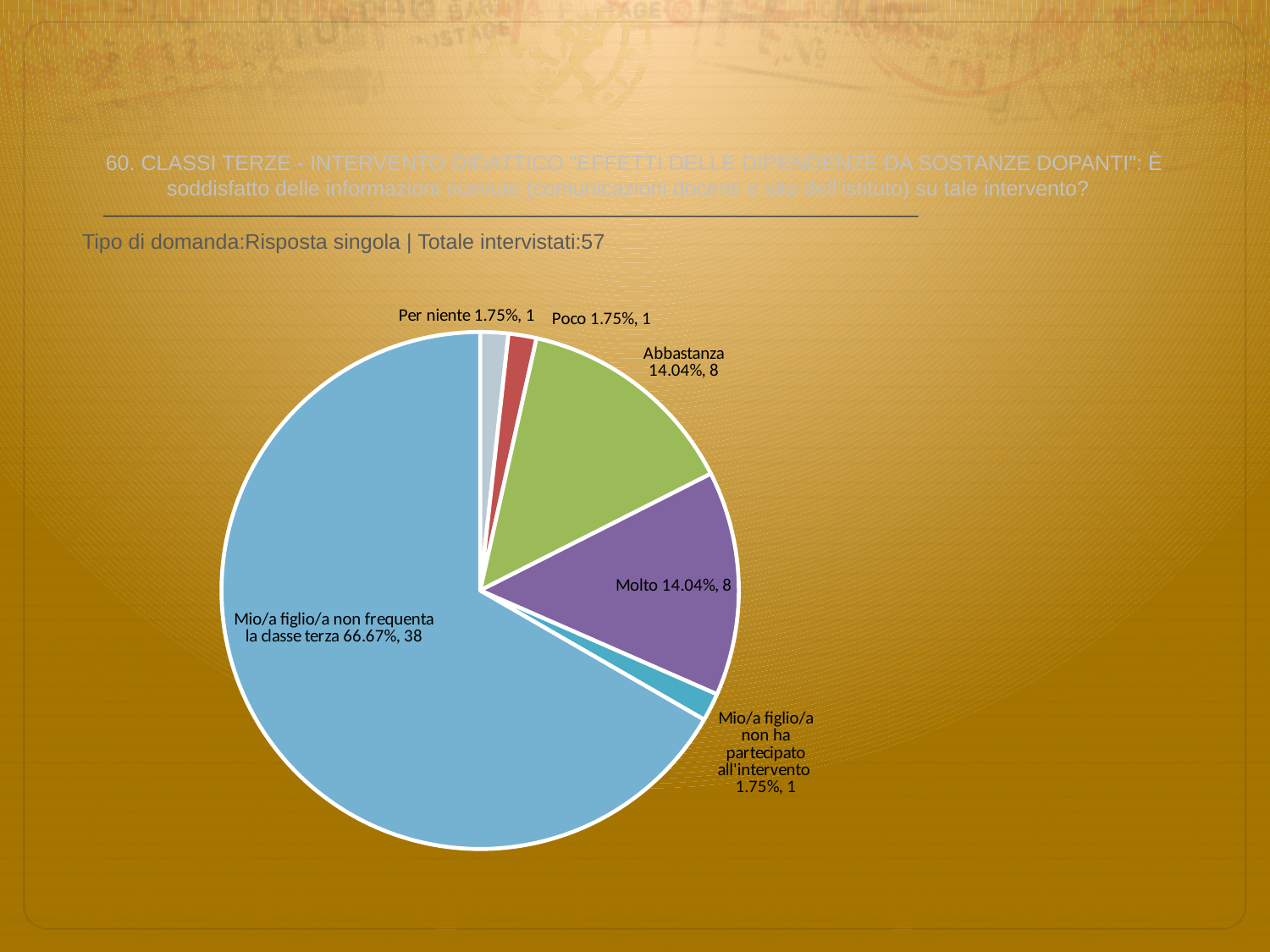
What is the difference in count between "Mio/a figlio/a non frequenta la classe terza" and "Abbastanza"? 30 How many respondents answered "Molto"? 8 How many respondents answered "Poco"? 1 What percentage is shown for "Mio/a figlio/a non frequenta la classe terza"? 66.67% What percentage is shown for "Mio/a figlio/a non ha partecipato all'intervento"? 1.75% What kind of chart is shown on the slide? Pie chart What is the total number of respondents stated on the slide (Totale intervistati)? 57 What percentage of the pie does the "Abbastanza" slice represent? 14.04% How many slices does the pie chart have? 6 Which is larger, the "Abbastanza" slice or the "Poco" slice? Abbastanza What is the combined count of the "Abbastanza" and "Molto" slices? 16 Which category has the largest slice of the pie? Mio/a figlio/a non frequenta la classe terza